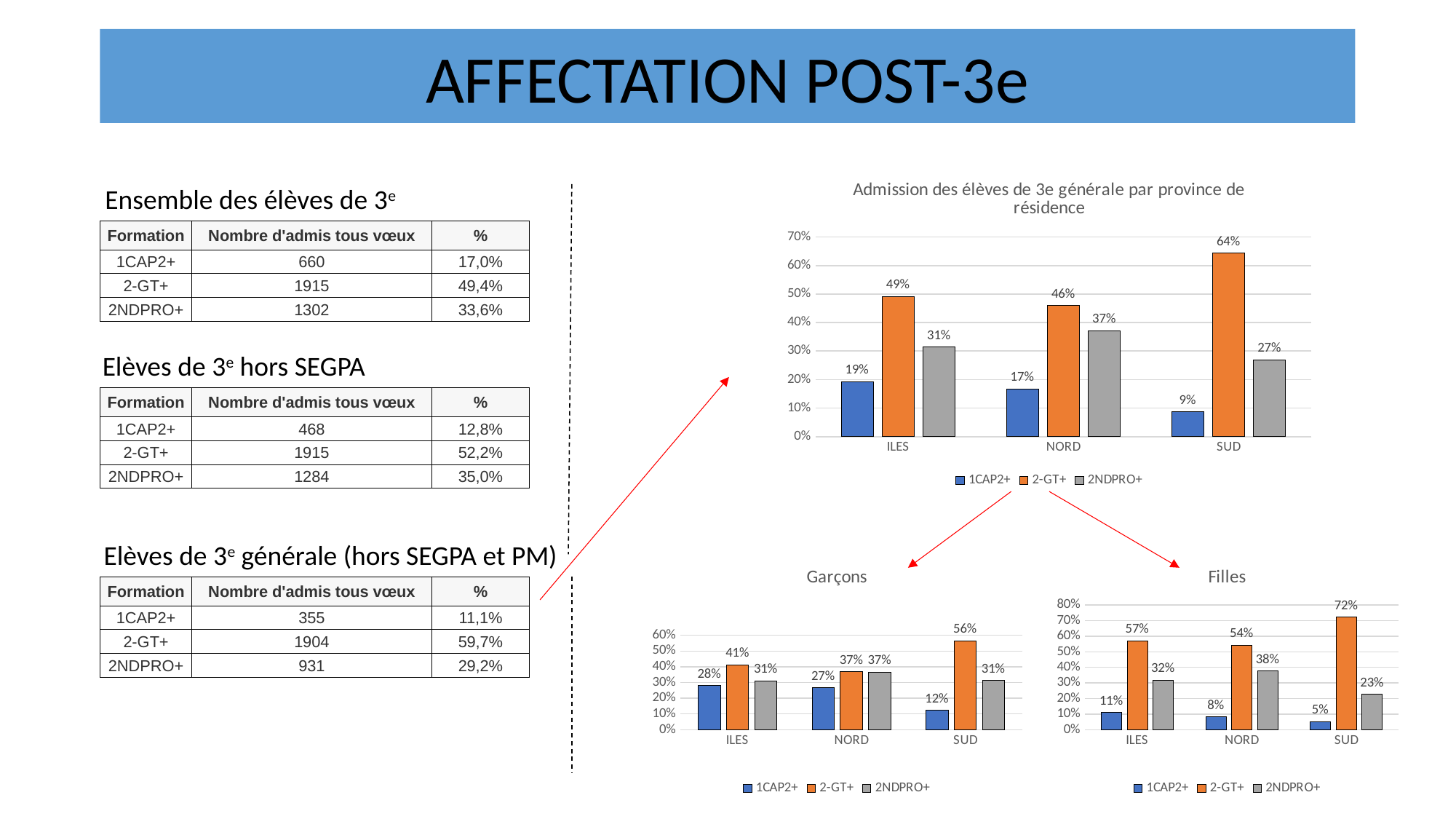
In the chart 'Admission des élèves de 3e générale par province de résidence', which province has the lowest value for 1CAP2+? SUD In the 'Filles' chart, what is the value for 2-GT+ in SUD? 72% In the 'Garçons' chart, which province has the highest value for 1CAP2+? ILES In the 'Garçons' chart, is the value for 2-GT+ in NORD larger or smaller than the value for 2NDPRO+ in NORD? They are equal (37%) In the 'Filles' chart, how many provinces are shown on the x axis? 3 In the 'Garçons' chart, what is the value for 2-GT+ in SUD? 56% In the chart 'Admission des élèves de 3e générale par province de résidence', what is the difference between the 2NDPRO+ values for NORD and SUD? 10% How many series does the legend of the 'Admission des élèves de 3e générale par province de résidence' chart list? 3 What type of chart is the 'Filles' chart? Bar chart In the chart 'Admission des élèves de 3e générale par province de résidence', what is the value for 1CAP2+ in NORD? 17% In the chart 'Admission des élèves de 3e générale par province de résidence', what is the value for 2-GT+ in SUD? 64% In the 'Filles' chart, what is the difference between the 2-GT+ values for ILES and NORD? 3%